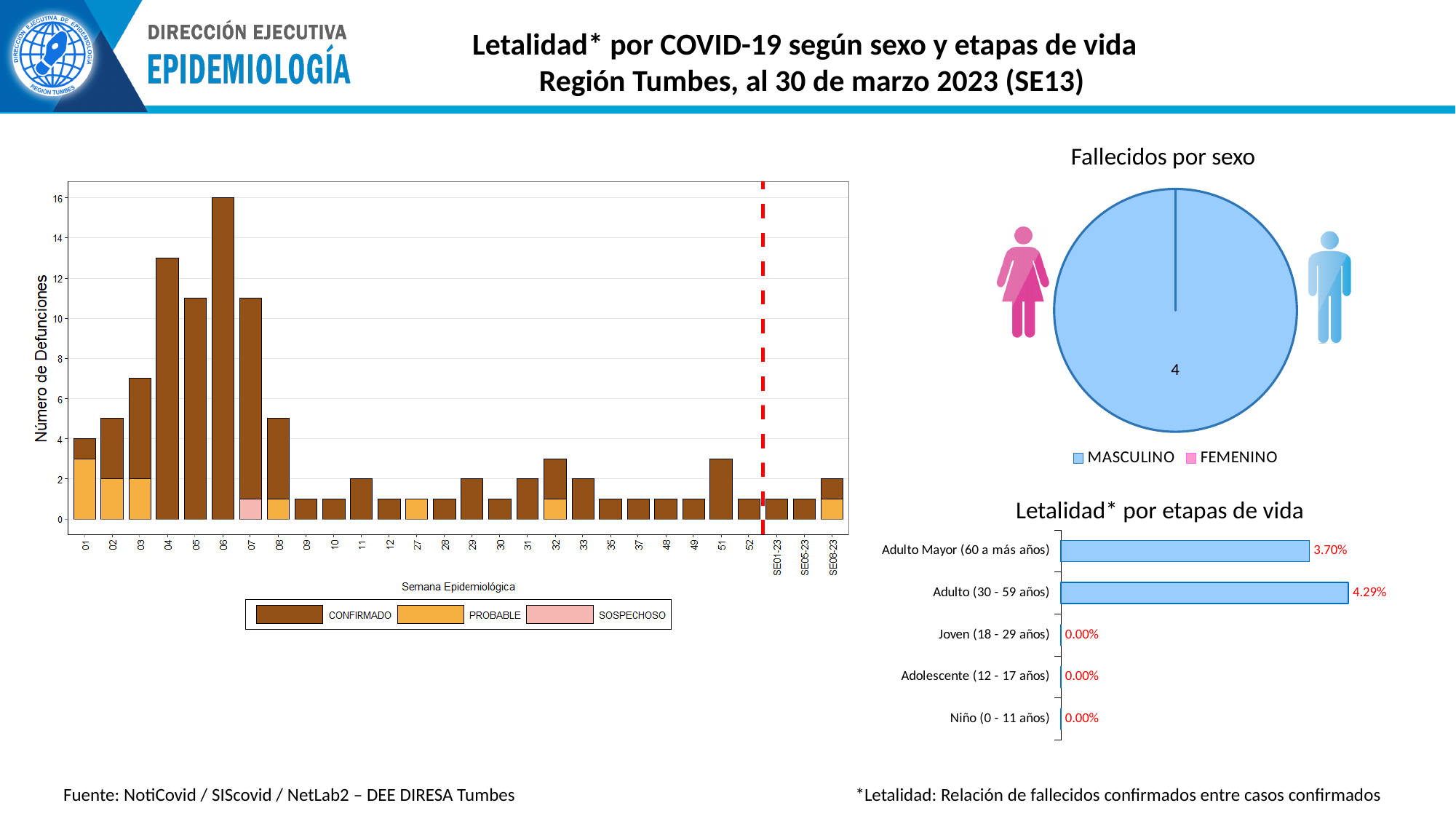
In the 'Letalidad* por etapas de vida' chart, what is the value for Joven (18 - 29 años)? 0.00% In the 'Fallecidos por sexo' pie chart, what value is printed on the pie? 4 In the bar chart of deaths by Semana Epidemiológica on the left, how many series does the legend list? 3 In the 'Letalidad* por etapas de vida' chart, what is the difference between Adulto (30 - 59 años) and Adulto Mayor (60 a más años)? 0.59% In the 'Letalidad* por etapas de vida' chart, what is the value for Adulto (30 - 59 años)? 4.29% In the 'Fallecidos por sexo' pie chart, how many entries does the legend list? 2 In the bar chart of deaths by Semana Epidemiológica on the left, what is the total number of deaths in week 06? 16 In the bar chart of deaths by Semana Epidemiológica on the left, is the total for week 04 greater or less than 12? greater In the bar chart of deaths by Semana Epidemiológica on the left, which week has the highest total number of deaths? 06 In the 'Letalidad* por etapas de vida' chart, what is the value for Adulto Mayor (60 a más años)? 3.70% In the 'Letalidad* por etapas de vida' chart, which age group has the highest value? Adulto (30 - 59 años) In the 'Letalidad* por etapas de vida' chart, how many age groups are shown? 5